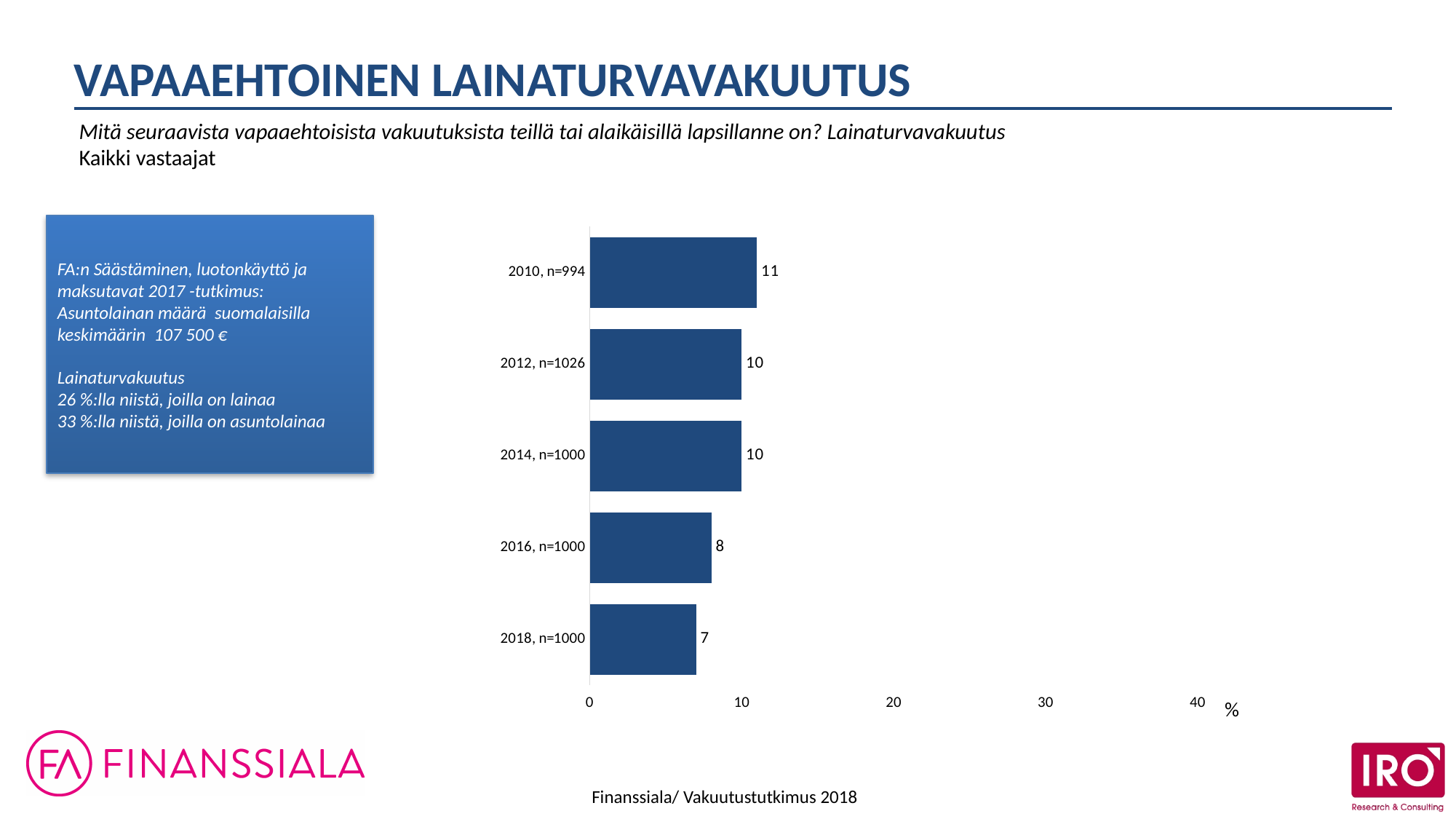
Is the value for 2014, n=1000 greater or less than 20? less Which is larger, the value for 2012, n=1026 or the value for 2016, n=1000? 2012, n=1026 What is the difference between the values for 2010, n=994 and 2018, n=1000? 4 Which category has the lowest value? 2018, n=1000 Do the values rise or fall from 2010 to 2018? fall How many categories are shown in the chart? 5 What is the value for 2018, n=1000? 7 What is the value for 2016, n=1000? 8 What kind of chart is shown on the slide? bar chart What unit is shown at the end of the horizontal axis? % What is the value for 2010, n=994? 11 Which category has the highest value? 2010, n=994